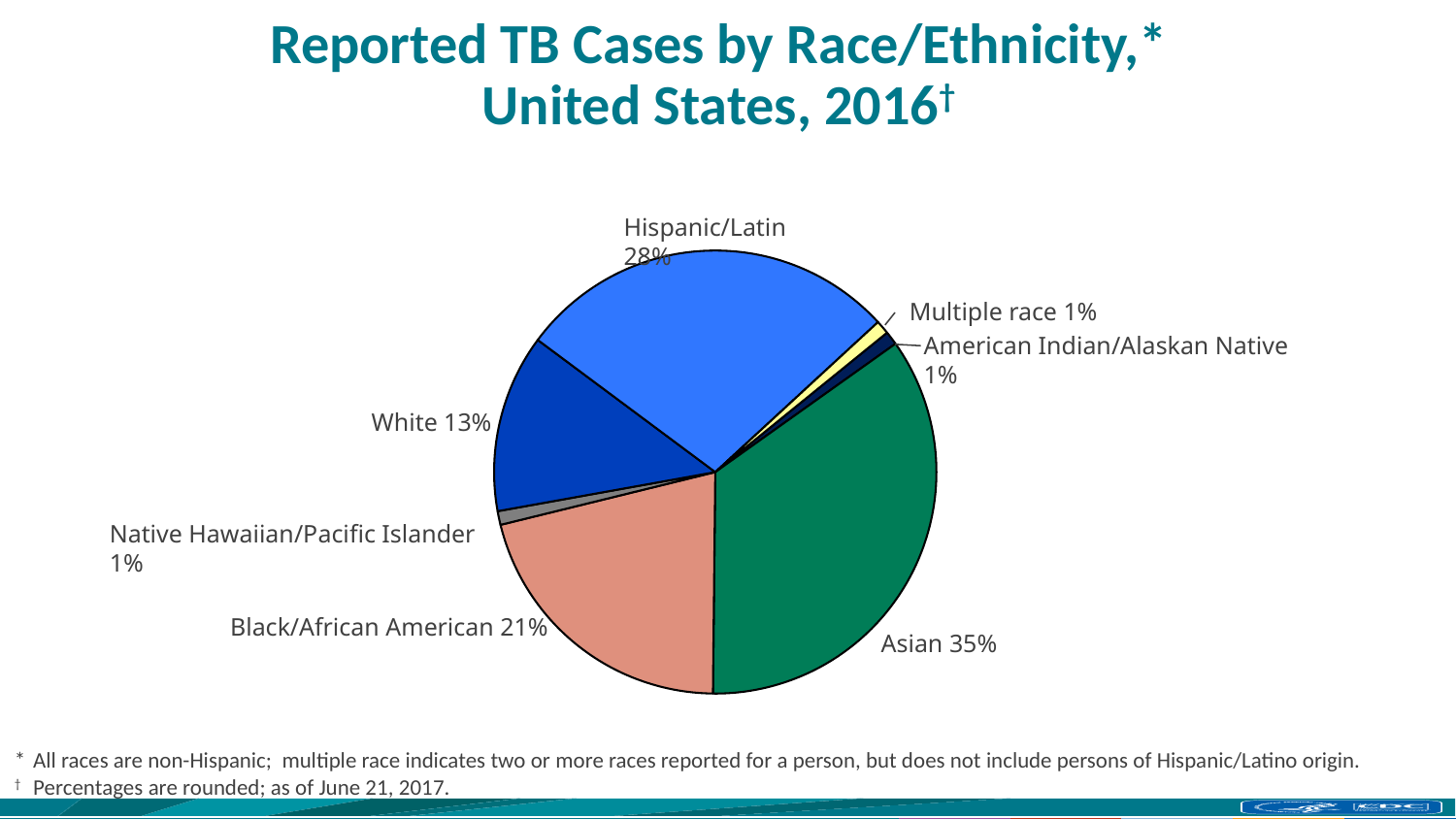
Which race/ethnicity group has the largest share of reported TB cases? Asian What share of reported TB cases is Black/African American? 21% What share of reported TB cases is Asian? 35% What is the title of the chart? Reported TB Cases by Race/Ethnicity, United States, 2016 How many race/ethnicity categories are shown in the pie chart? 7 What share of reported TB cases is White? 13% Which is larger, the share for Black/African American or the share for White? Black/African American What kind of chart is shown on the slide? Pie chart What is the difference in percentage points between the Asian and Hispanic/Latin shares? 7 What share of reported TB cases is Native Hawaiian/Pacific Islander? 1% What is the difference in percentage points between the Black/African American and White shares? 8 What share of reported TB cases is Hispanic/Latin? 28%